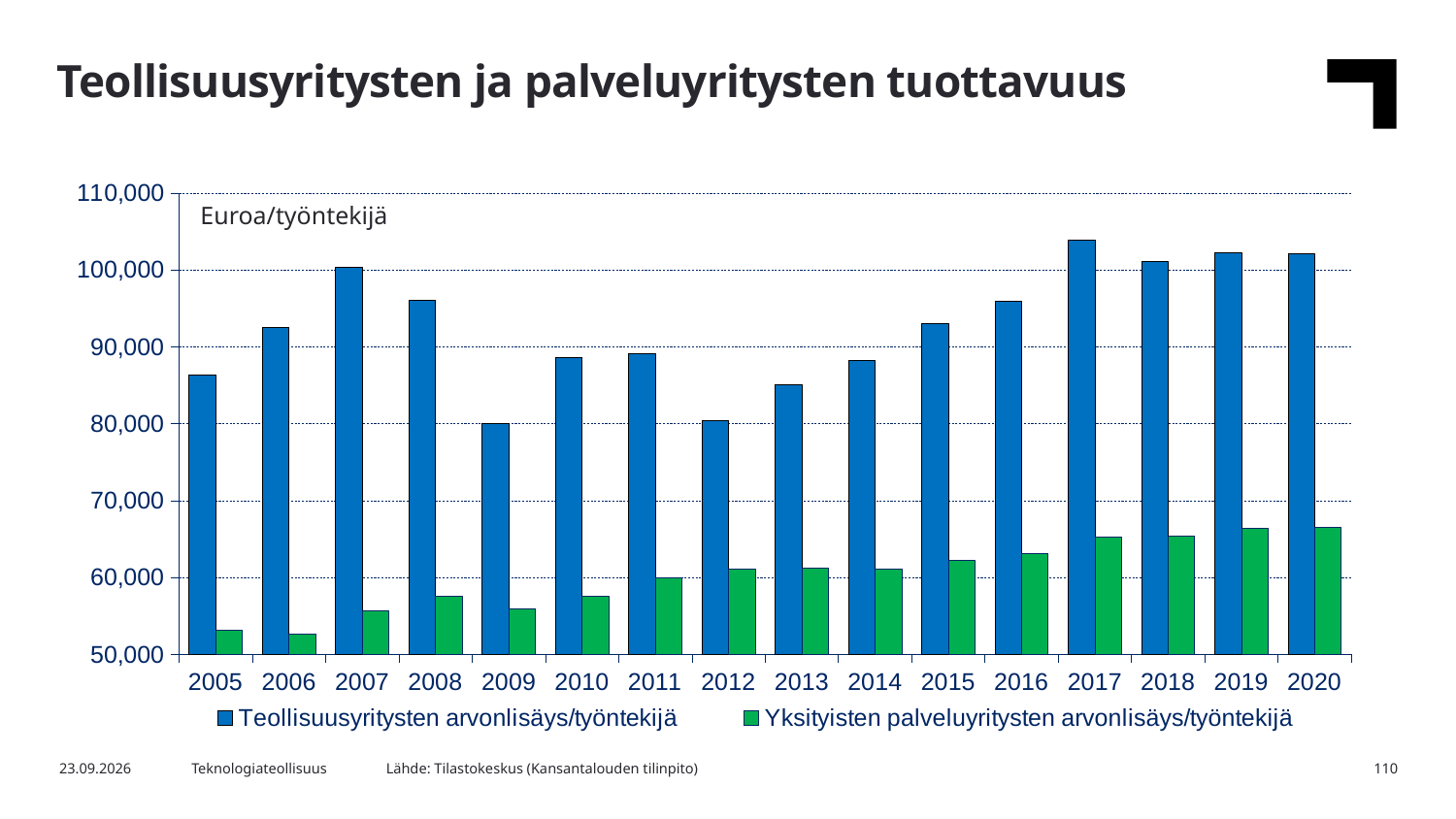
Is the value for Yksityisten palveluyritysten arvonlisäys/työntekijä in 2020 greater or less than 60,000? greater How many series does the legend list? 2 Is the value for Teollisuusyritysten arvonlisäys/työntekijä in 2009 greater or less than 90,000? less What colour are the bars for Yksityisten palveluyritysten arvonlisäys/työntekijä? green Is the value for Teollisuusyritysten arvonlisäys/työntekijä in 2017 greater or less than 100,000? greater Which is larger: the value for Teollisuusyritysten arvonlisäys/työntekijä in 2015 or in 2013? 2015 Does the value for Yksityisten palveluyritysten arvonlisäys/työntekijä generally rise or fall from 2005 to 2020? rise How many years are shown on the x axis? 16 What is the title of the chart? Teollisuusyritysten ja palveluyritysten tuottavuus In which year is the value for Teollisuusyritysten arvonlisäys/työntekijä highest? 2017 What kind of chart is shown on the slide? bar chart